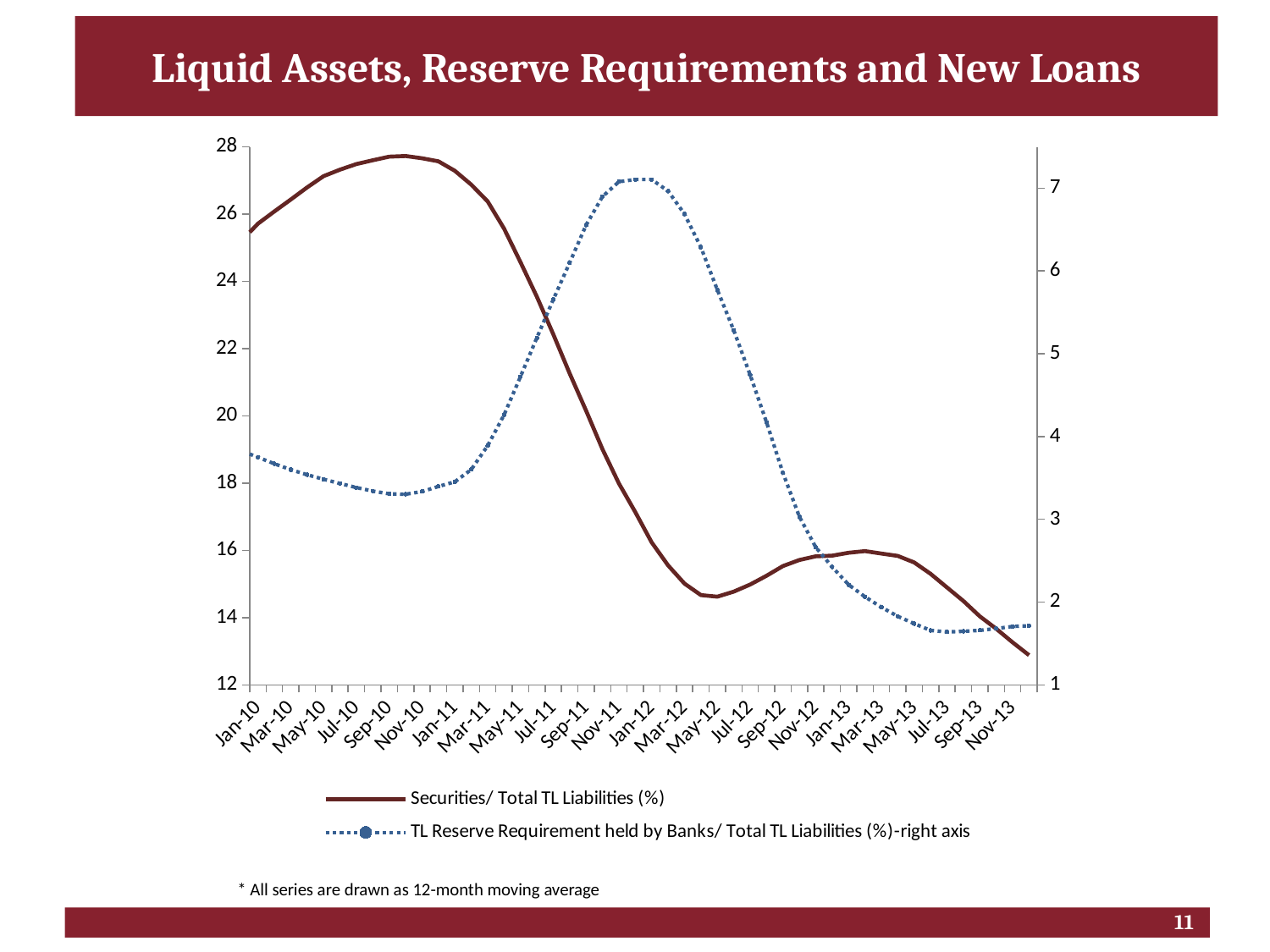
Is the value of TL Reserve Requirement held by Banks/ Total TL Liabilities (%) in Sep-10 greater or less than 4 on the right axis? less Is the value of Securities/ Total TL Liabilities (%) in Nov-13 greater or less than 14? less According to the footnote, how are all series drawn? As 12-month moving average Is the value of Securities/ Total TL Liabilities (%) in Nov-10 greater or less than 26? greater Which series is plotted against the right axis? TL Reserve Requirement held by Banks/ Total TL Liabilities (%) Which is larger for Securities/ Total TL Liabilities (%): the value in Jan-10 or the value in Nov-13? Jan-10 Does the TL Reserve Requirement held by Banks/ Total TL Liabilities (%) series rise or fall between Jan-11 and Jan-12? Rise What kind of chart is shown on the slide? Line chart How many series does the legend list? 2